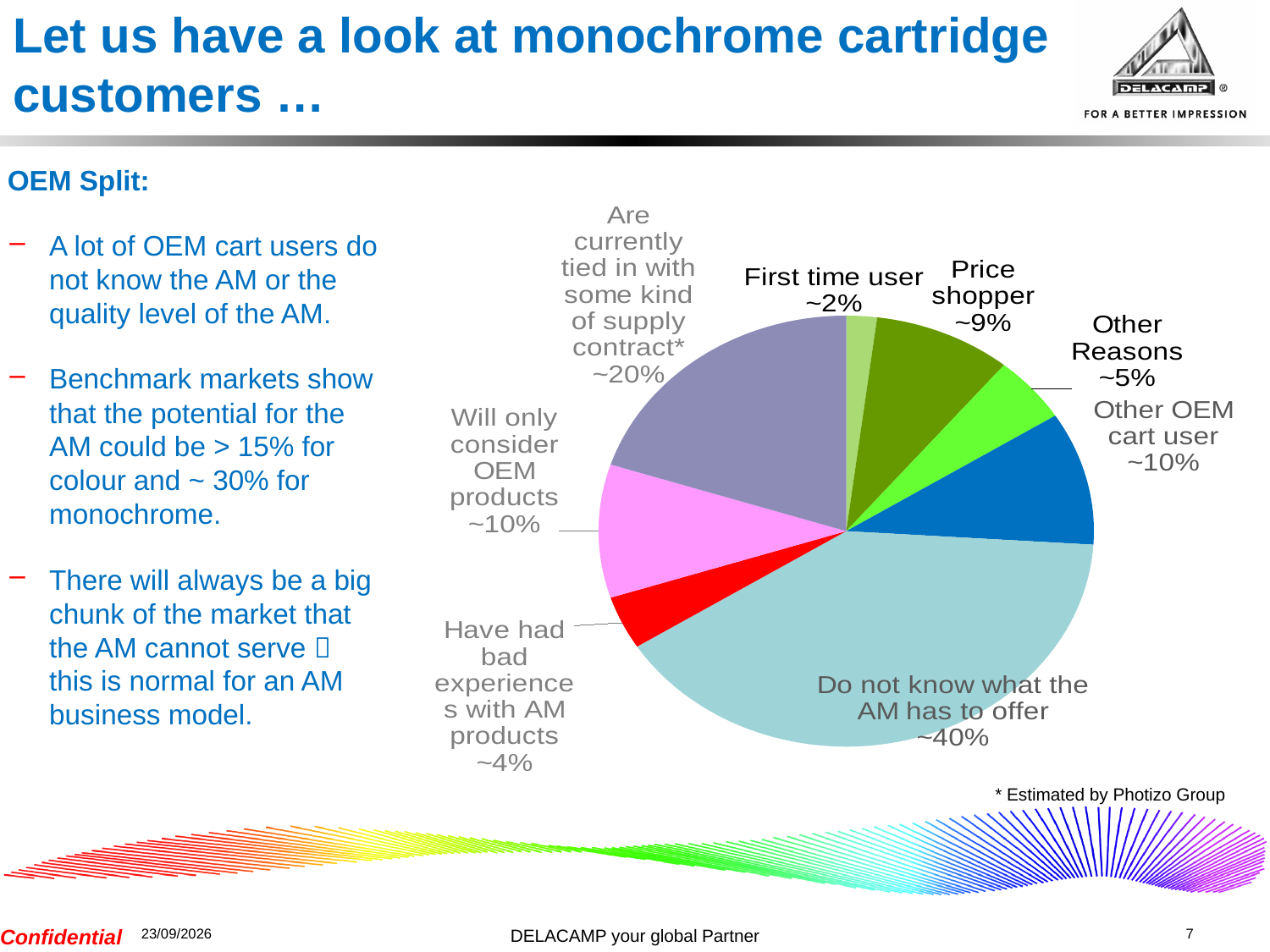
What value is shown for 'First time user'? ~2% What value is shown for 'Are currently tied in with some kind of supply contract*'? ~20% Which slice of the pie is the smallest? First time user What value is shown for 'Other OEM cart user'? ~10% What kind of chart is shown on the slide? pie chart According to the footnote, who estimated the supply contract figure? Photizo Group What value is shown for 'Have had bad experiences with AM products'? ~4% Which slice of the pie is the largest? Do not know what the AM has to offer What share of the pie is labelled for 'Do not know what the AM has to offer'? ~40% Which is larger, the 'Price shopper' slice or the 'Other Reasons' slice? Price shopper What value is shown for 'Price shopper'? ~9% How many slices does the pie chart have? 8